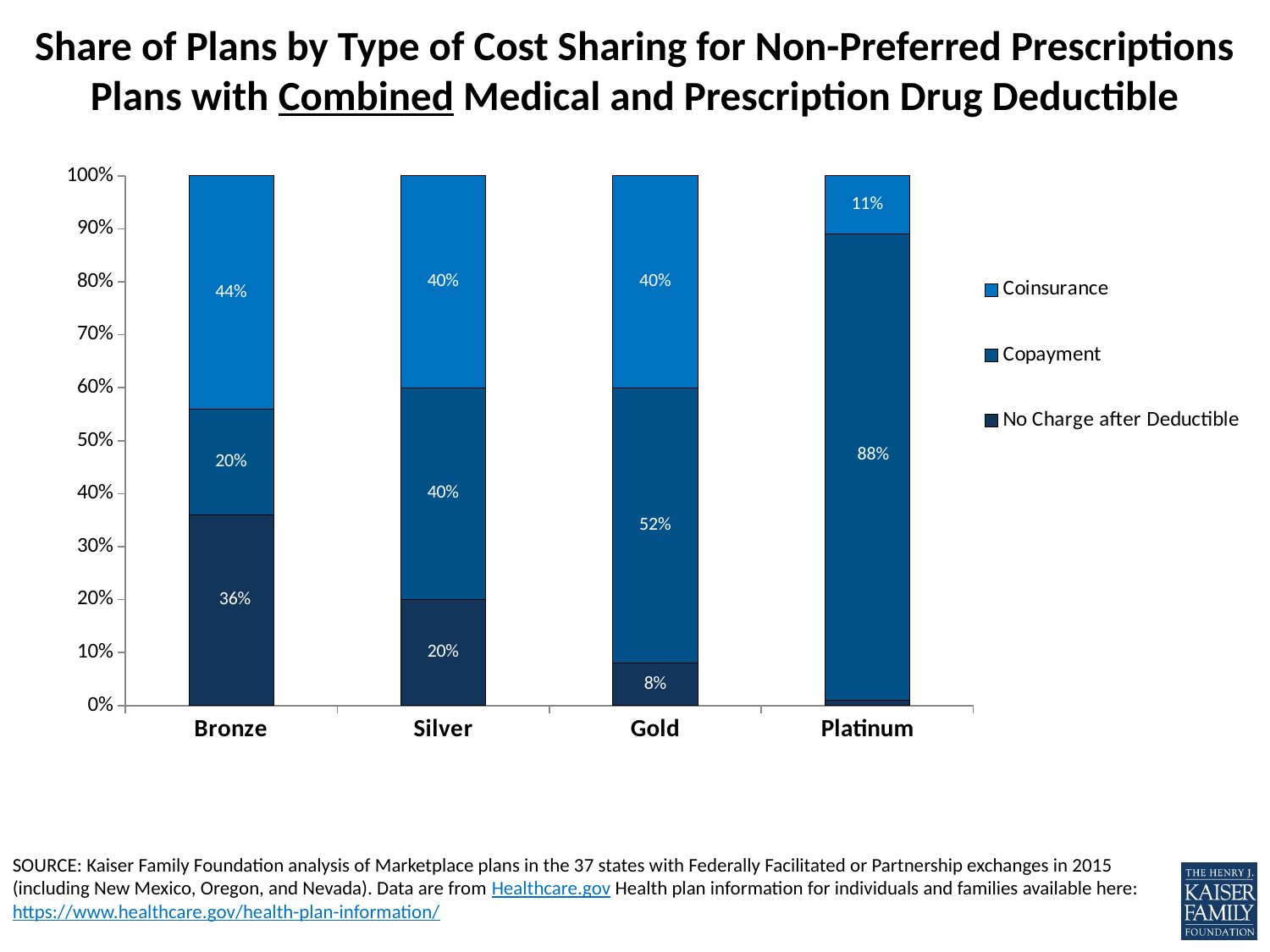
What is the difference between the Copayment share for Gold and the Copayment share for Bronze? 32 percentage points Which metal level has the highest Copayment share? Platinum How many metal levels are shown on the x axis? 4 What is the Copayment share for Platinum plans? 88% Is the No Charge after Deductible share larger for Bronze or for Gold? Bronze What is the No Charge after Deductible value for Silver plans? 20% How many series does the legend list? 3 What is the Copayment value for Gold plans? 52% What share of Bronze plans have coinsurance for non-preferred prescriptions? 44% Which metal level has the lowest Coinsurance share? Platinum What kind of chart is shown on the slide? Stacked bar chart Which legend entry is shown in the lightest blue? Coinsurance